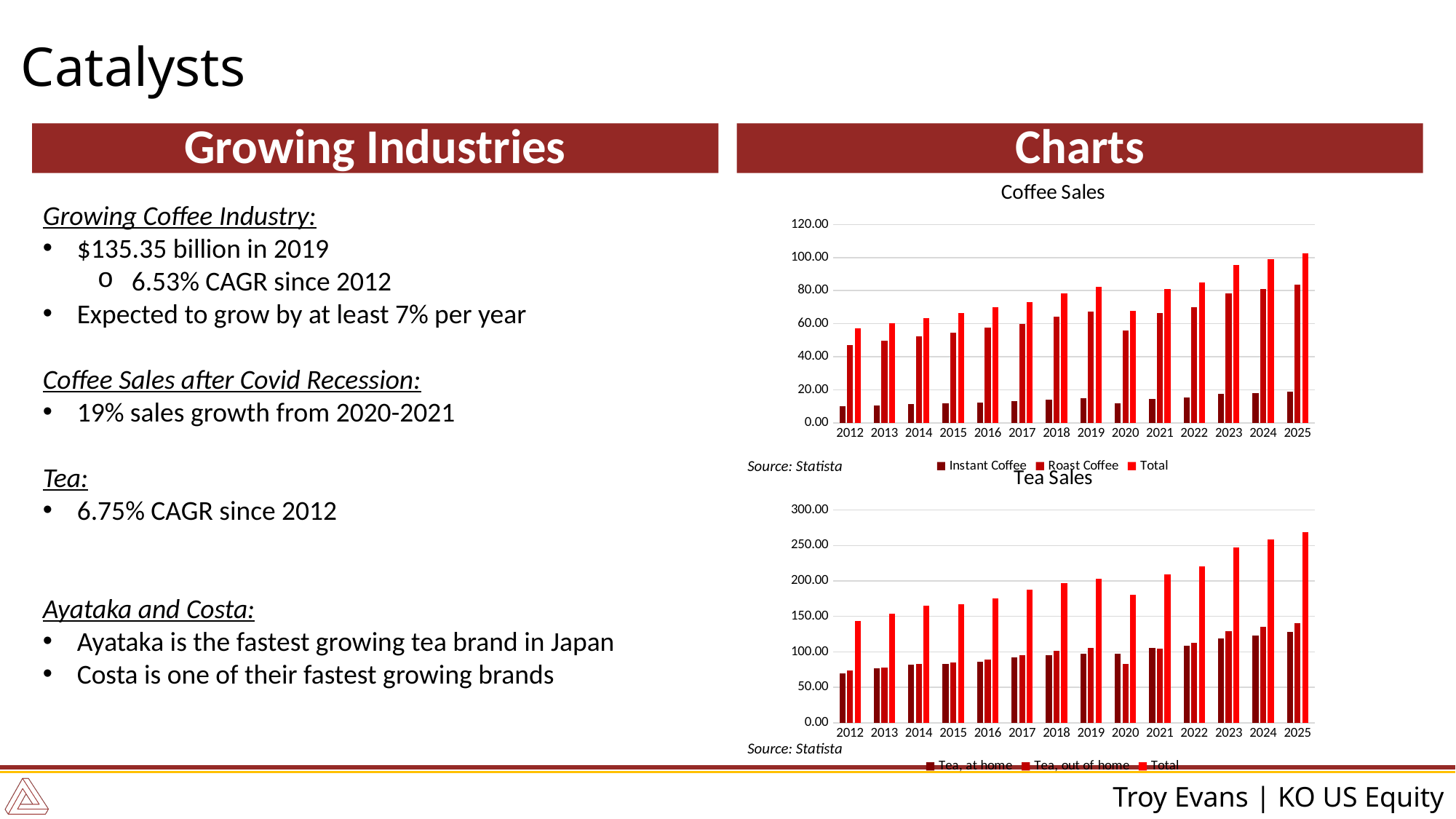
On the Tea Sales chart, which year has the lowest Total value? 2012 On the Coffee Sales chart, how many series does the legend list? 3 On the Tea Sales chart, what source is cited below the chart? Statista On the Coffee Sales chart, which year has the highest Total value? 2025 On the Tea Sales chart, how many series does the legend list? 3 On the Coffee Sales chart, what kind of chart is it? bar chart On the Tea Sales chart, is the Total value for 2012 greater or less than 150.00? less On the Coffee Sales chart, is the Instant Coffee value for 2012 greater or less than 20.00? less On the Tea Sales chart, is the Total value for 2025 greater or less than 250.00? greater On the Coffee Sales chart, how many years are shown on the x axis? 14 On the Coffee Sales chart, which year has the larger Total value, 2019 or 2020? 2019